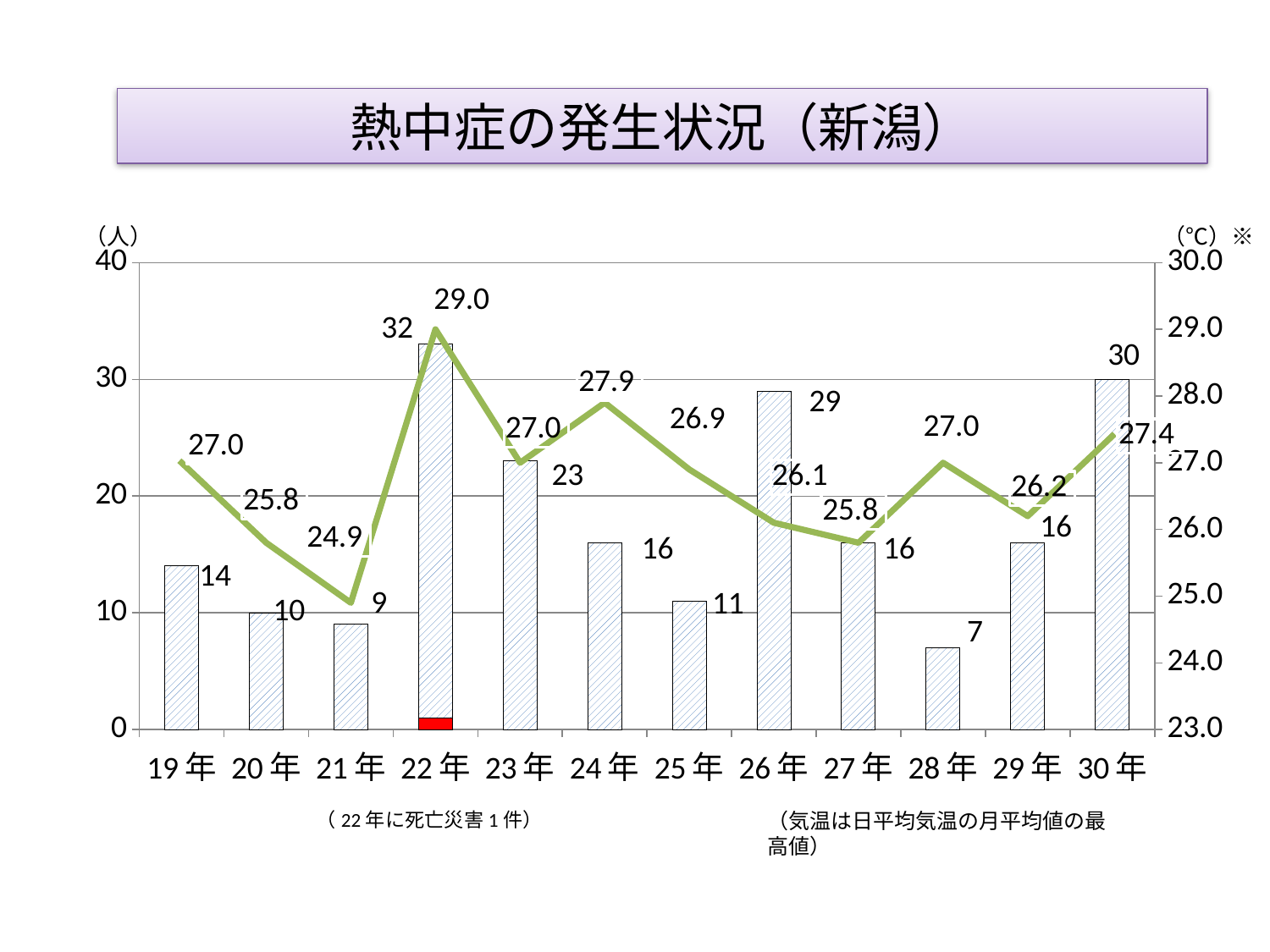
How many years are shown on the x axis? 12 What is the number of heatstroke cases (人) shown for 28年? 7 Which year has the lowest number of heatstroke cases (人)? 28年 What is the title of the chart? 熱中症の発生状況（新潟） Which year has the highest number of heatstroke cases (人)? 22年 What temperature (℃) is shown on the line for 24年? 27.9 What is the difference in heatstroke cases (人) between 22年 and 30年? 2 What kind of chart is shown on the slide? Combined bar and line chart Which year has the lowest temperature (℃) on the line? 21年 Is the number of heatstroke cases (人) for 25年 greater or less than 20? less What is the number of heatstroke cases (人) shown for 22年? 32 Which year has more heatstroke cases (人), 26年 or 23年? 26年